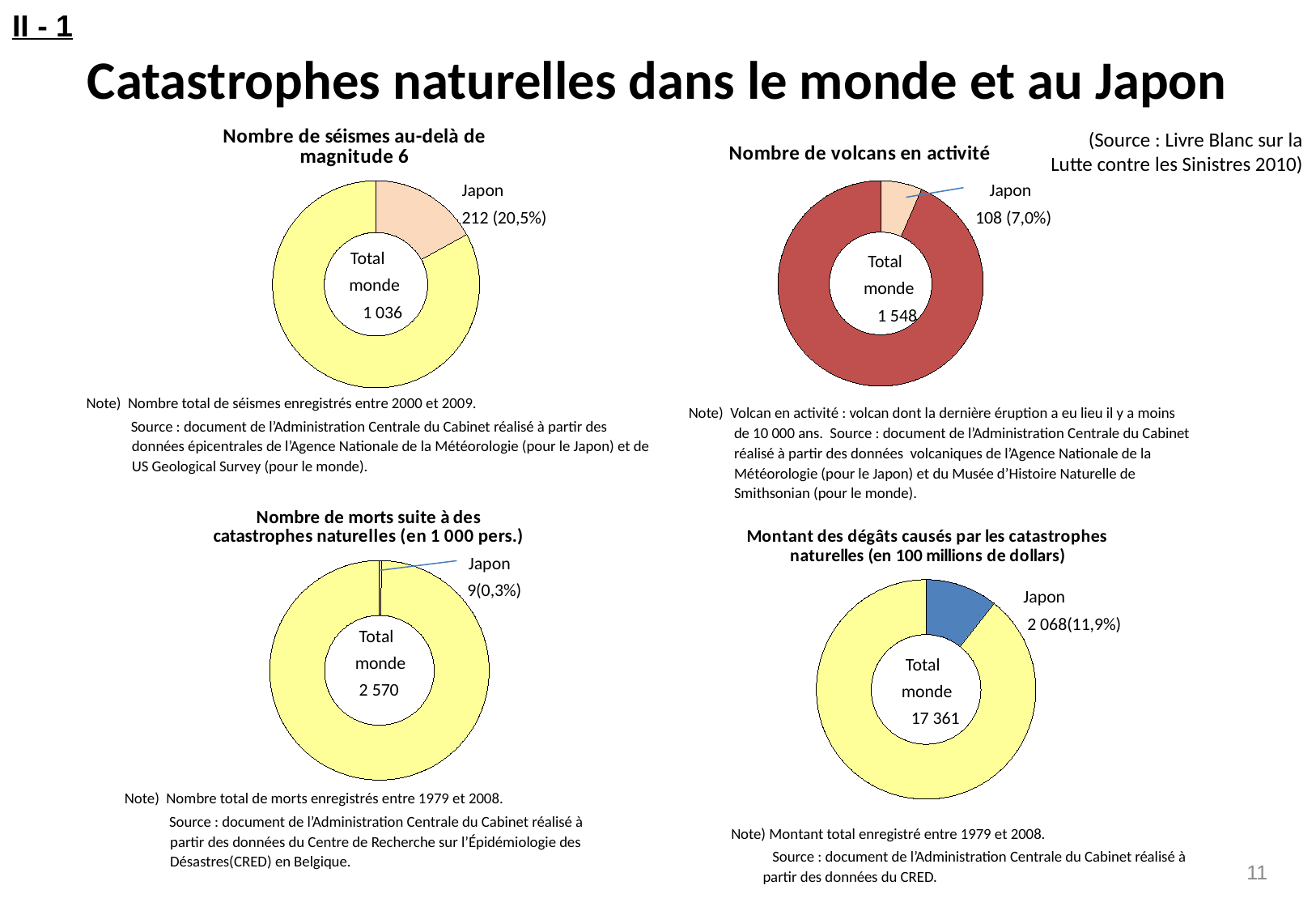
In the chart titled "Nombre de séismes au-delà de magnitude 6", what is the Total monde value? 1 036 In the chart titled "Nombre de séismes au-delà de magnitude 6", what is the value shown for Japon? 212 In the chart titled "Nombre de morts suite à des catastrophes naturelles (en 1 000 pers.)", what is the Total monde value? 2 570 In the chart titled "Nombre de séismes au-delà de magnitude 6", what share of the total does Japon represent? 20,5% In the chart titled "Nombre de séismes au-delà de magnitude 6", what is the difference between the Total monde value and the Japon value? 824 What kind of chart is used for the four charts on this slide? Doughnut (pie) chart In the chart titled "Montant des dégâts causés par les catastrophes naturelles (en 100 millions de dollars)", what share of the total does Japon represent? 11,9% In the chart titled "Nombre de volcans en activité", what is the value shown for Japon? 108 In the chart titled "Montant des dégâts causés par les catastrophes naturelles (en 100 millions de dollars)", what is the value shown for Japon? 2 068 In the chart titled "Nombre de volcans en activité", what is the Total monde value? 1 548 In the chart titled "Nombre de morts suite à des catastrophes naturelles (en 1 000 pers.)", what is the value shown for Japon? 9 In the chart titled "Nombre de volcans en activité", what percentage share does Japon have? 7,0%